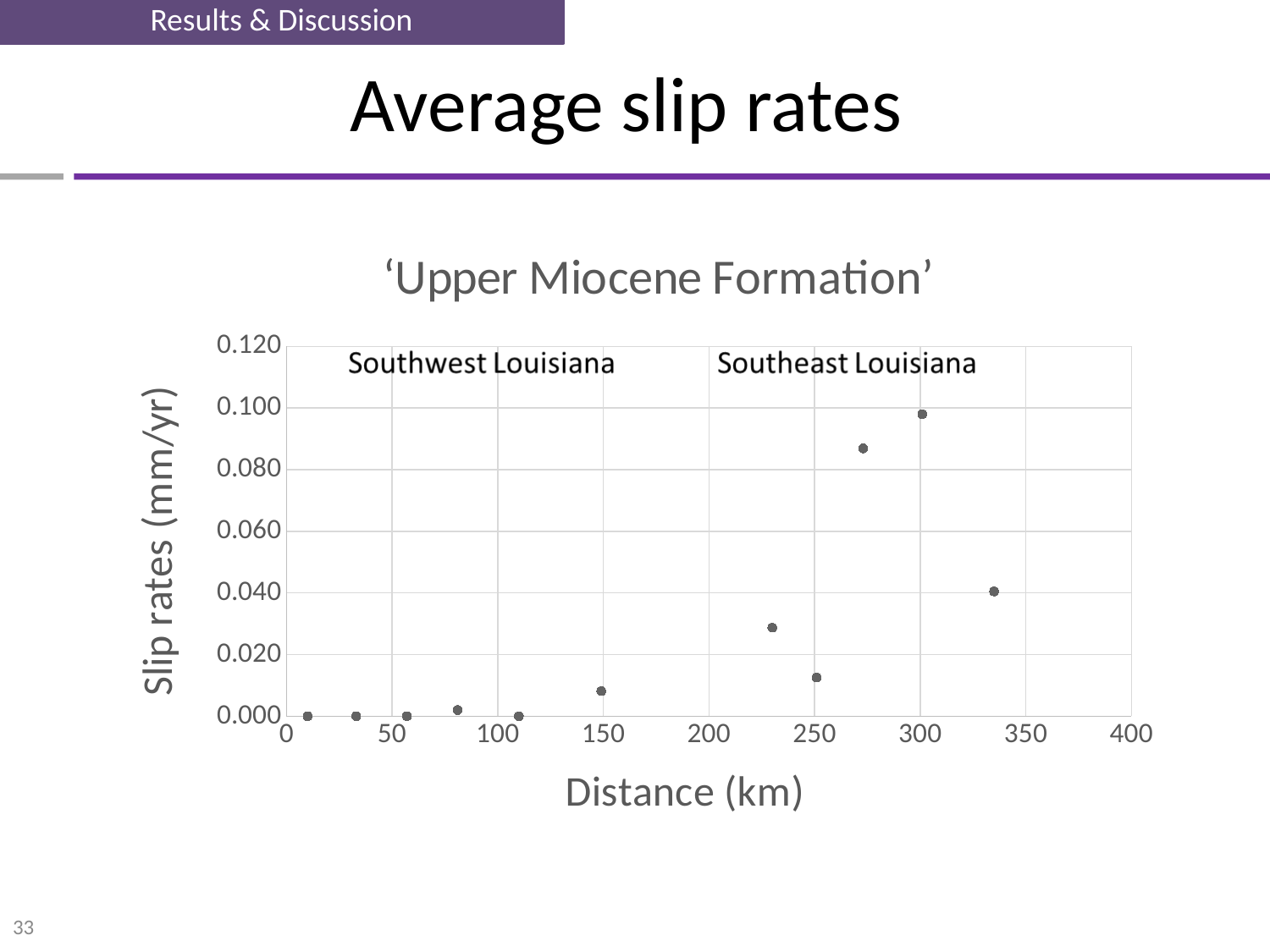
Is the slip rate for the point at about 273 km greater or less than 0.060 mm/yr? greater Is the slip rate for the point at about 230 km greater or less than 0.040 mm/yr? less Do slip rates generally rise or fall as distance increases along the x axis? Rise What is the title of the chart? 'Upper Miocene Formation' Which region has the lower slip rates overall, Southwest Louisiana or Southeast Louisiana? Southwest Louisiana What kind of chart is shown on the slide? Scatter plot Is the slip rate for the point at about 300 km greater or less than 0.080 mm/yr? greater How many data points are plotted on the chart? 11 Which has the larger slip rate: the point at about 300 km or the point at about 335 km? The point at about 300 km What is the label of the y axis? Slip rates (mm/yr) In which labelled region does the point with the highest slip rate fall? Southeast Louisiana